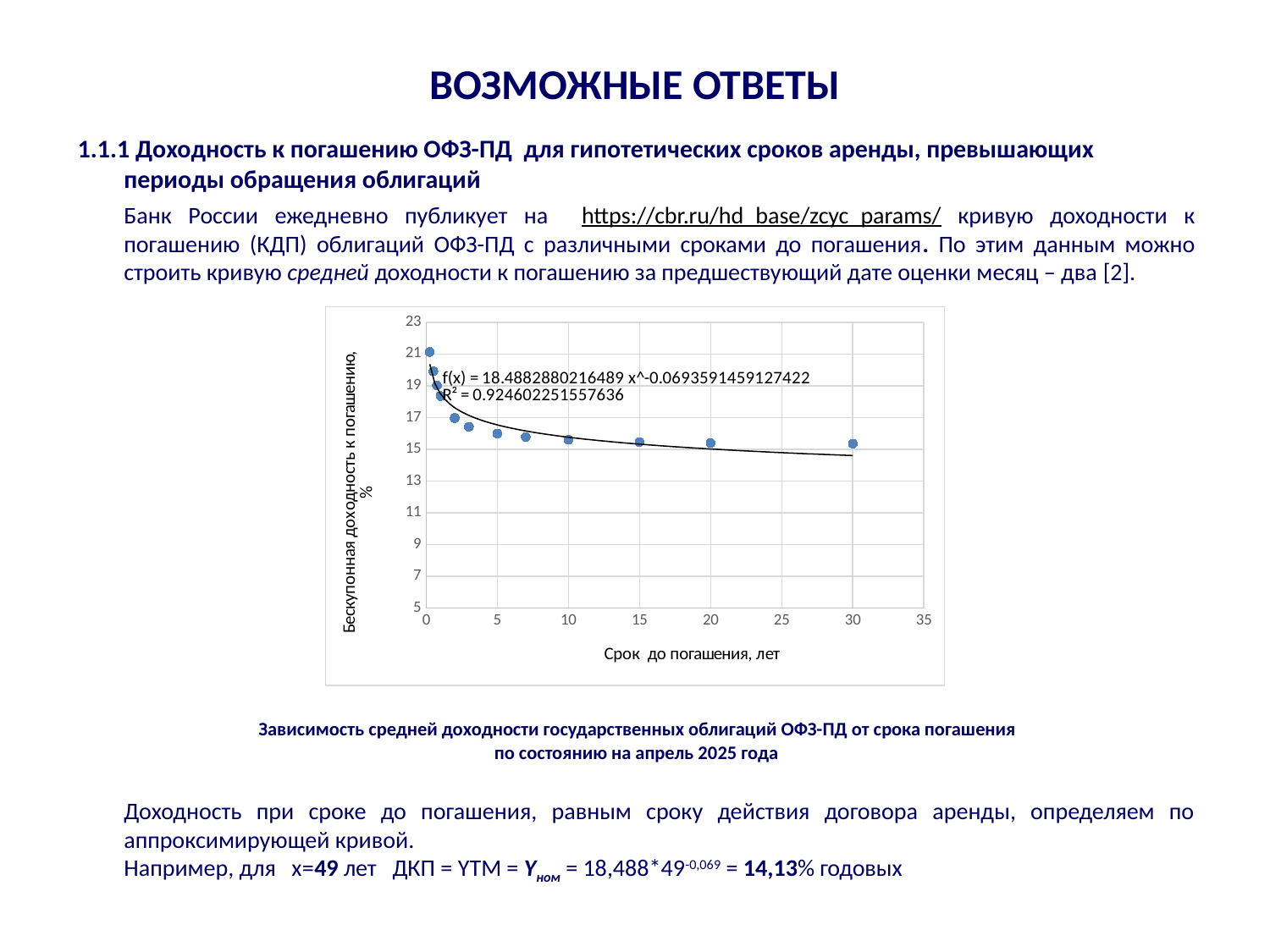
What is the title of the x axis of the chart? Срок до погашения, лет What is the highest value shown on the y axis of the chart? 23 What kind of chart is shown on the slide? scatter chart Which point has the highest yield: the one nearest 0 years or the one at 30 years to maturity? the one nearest 0 years What is the fitted trendline equation printed on the chart? f(x) = 18.4882880216489 x^-0.0693591459127422 Is the yield value for the point at 30 years to maturity greater or less than 17? less Is the yield value for the point at 5 years to maturity greater or less than 17? less What is the R² value printed on the chart for the fitted curve? 0.924602251557636 Do the plotted yield values rise or fall as the term to maturity increases along the x axis? fall Is the yield value for the point at 10 years to maturity greater or less than 17? less